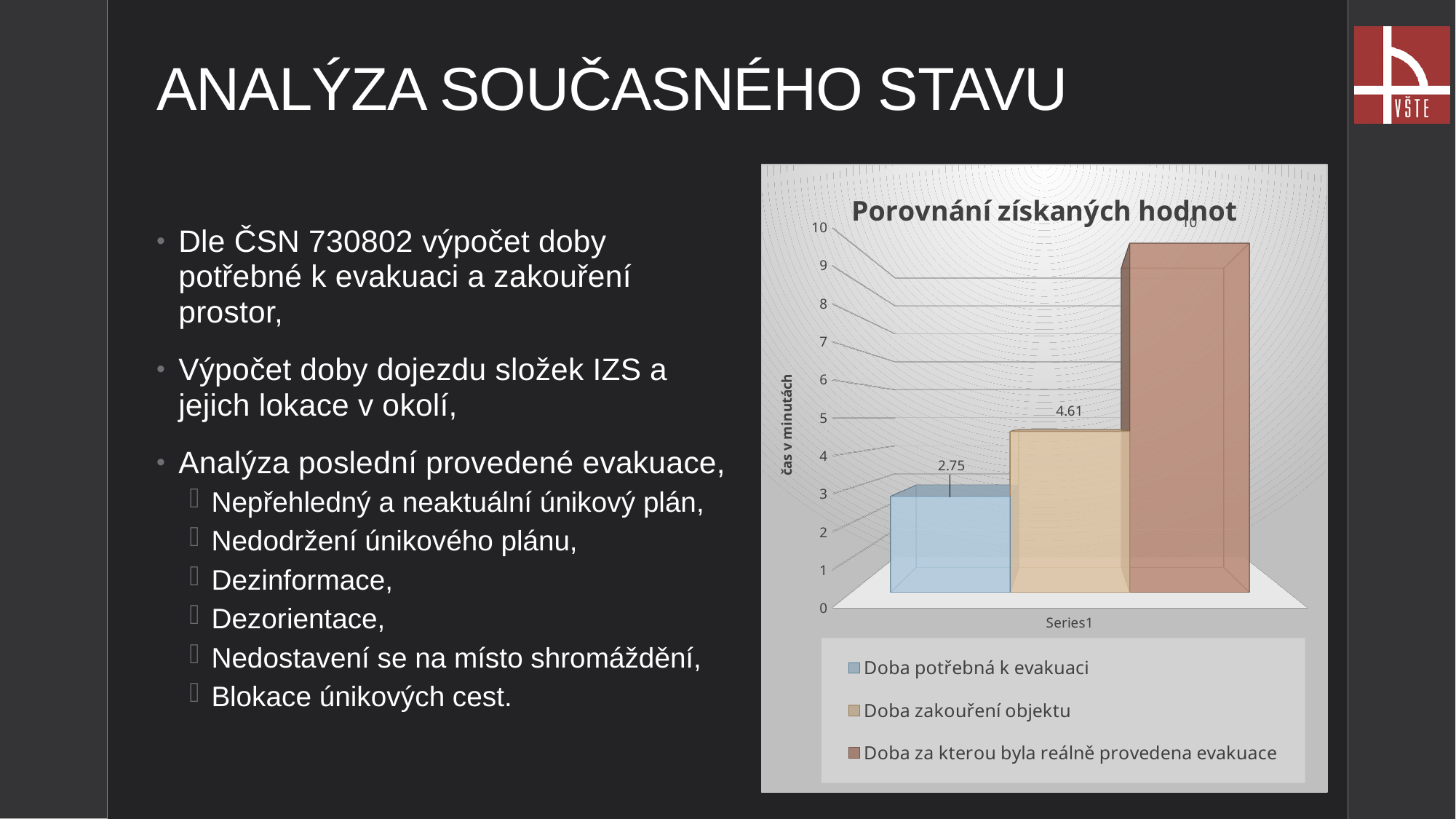
What is the label of the vertical axis? čas v minutách What kind of chart is shown on the slide? Bar chart What is the value for "Doba zakouření objektu"? 4.61 Which is larger, "Doba zakouření objektu" or "Doba potřebná k evakuaci"? Doba zakouření objektu Which series has the lowest value? Doba potřebná k evakuaci Which series has the highest value? Doba za kterou byla reálně provedena evakuace What is the value for "Doba za kterou byla reálně provedena evakuace"? 10 How many series does the legend list? 3 What is the title of the chart? Porovnání získaných hodnot What is the difference between "Doba za kterou byla reálně provedena evakuace" and "Doba zakouření objektu"? 5.39 What is the value for "Doba potřebná k evakuaci"? 2.75 What is the difference between "Doba zakouření objektu" and "Doba potřebná k evakuaci"? 1.86